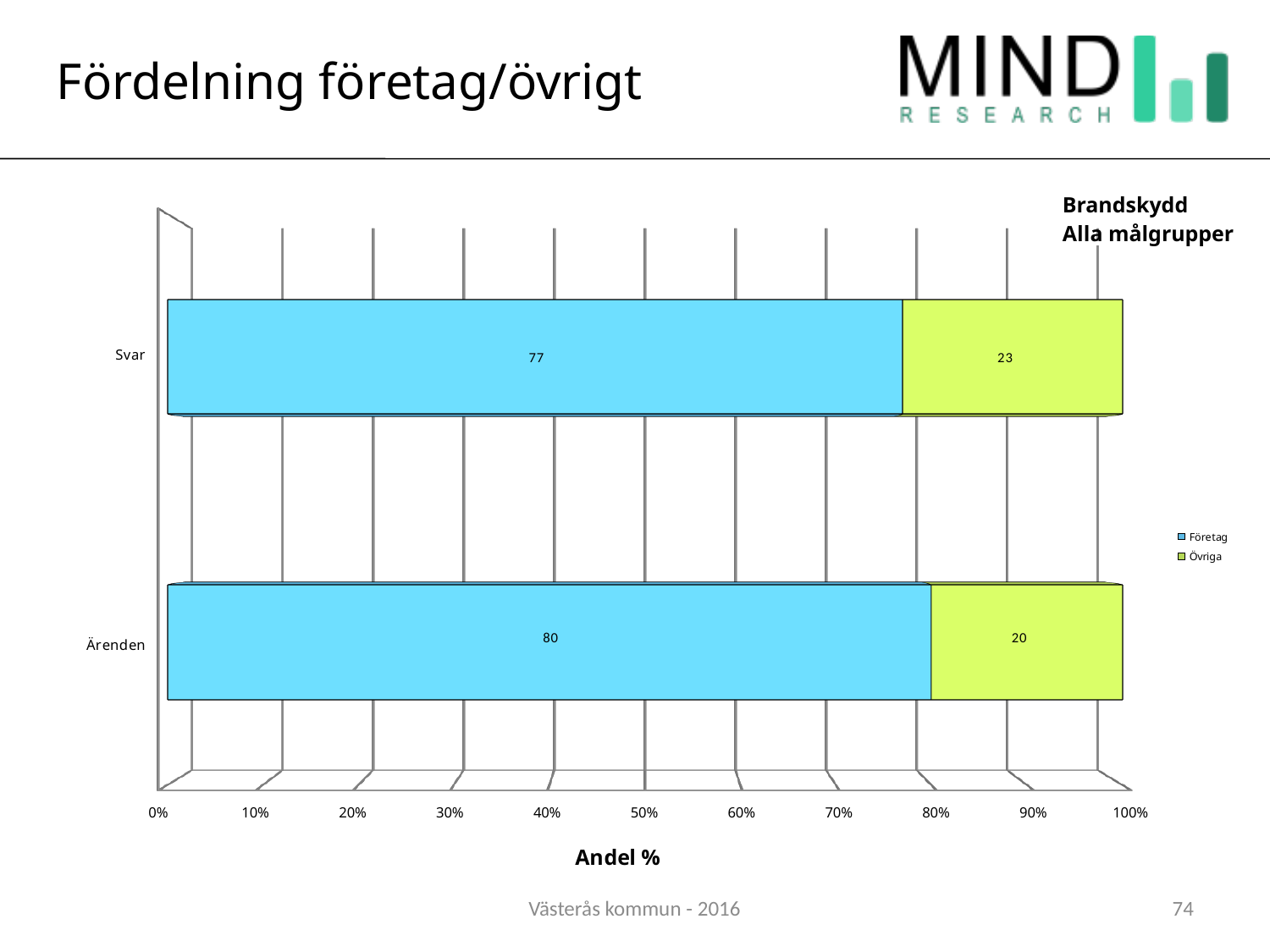
What is the Företag value for Svar? 77 Which category has the higher Företag value, Svar or Ärenden? Ärenden What is the total of the stacked bar for Svar? 100 What is the Övriga value for Ärenden? 20 What is the Företag value for Ärenden? 80 What is the label of the x axis? Andel % What is the difference between the Företag values for Ärenden and Svar? 3 How many categories are shown on the y axis? 2 What is the Övriga value for Svar? 23 What kind of chart is shown on the slide? Stacked bar chart How many series does the legend list? 2 Which category has the lowest Övriga value? Ärenden